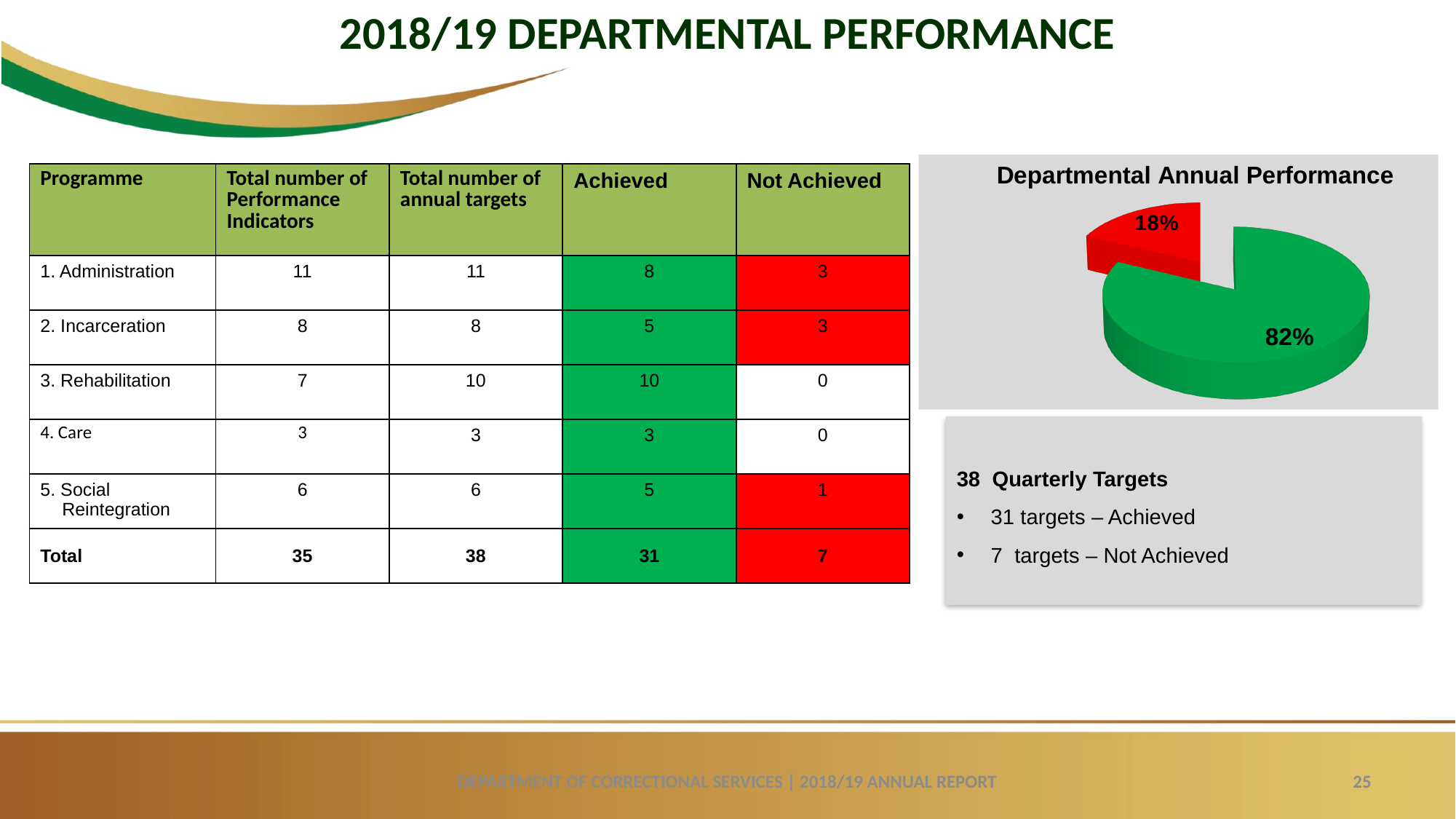
What is the difference in percentage points between the two slices of the pie chart? 64 How many slices does the pie chart have? 2 What percentage is shown on the green slice of the pie chart? 82% Which slice is larger in the pie chart, the green one or the red one? green Is the value of the red slice in the pie chart greater or less than 50%? less What is the title of the pie chart? Departmental Annual Performance Which slice of the pie chart is the smallest? 18% What colour is the largest slice of the pie chart? green What kind of chart is shown on the slide? pie chart Which slice of the pie chart is the largest? 82% What percentage is shown on the red slice of the pie chart? 18% What share of the pie chart does the red slice represent? 18%